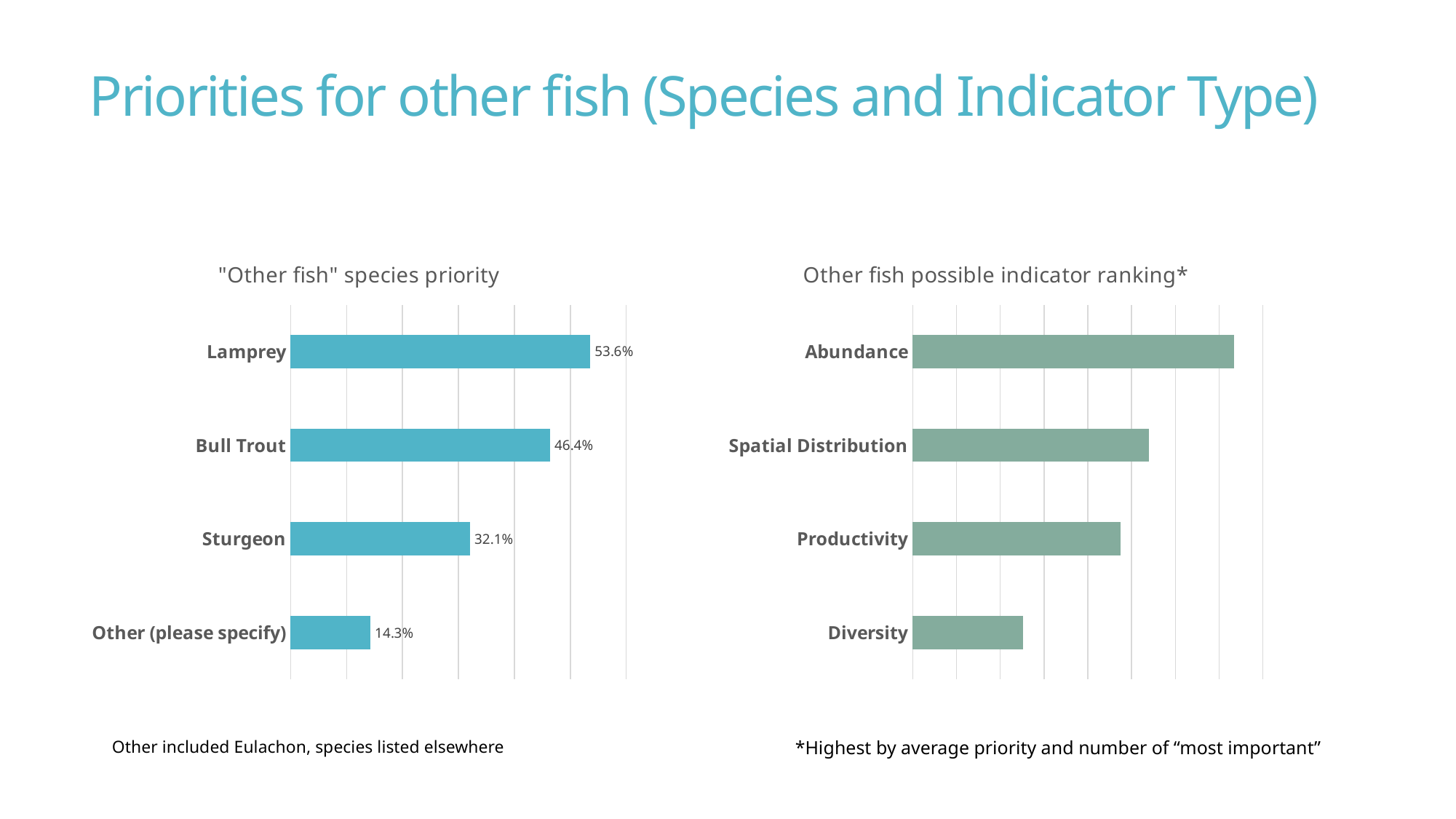
What type of chart is the Other fish possible indicator ranking chart? Bar chart In the "Other fish" species priority chart, which is larger, Bull Trout or Sturgeon? Bull Trout In the Other fish possible indicator ranking chart, which indicator has the shortest bar? Diversity In the "Other fish" species priority chart, what is the difference between Lamprey and Bull Trout? 7.2% In the "Other fish" species priority chart, which category has the lowest value? Other (please specify) In the Other fish possible indicator ranking chart, which is larger, Spatial Distribution or Productivity? Spatial Distribution In the "Other fish" species priority chart, what is the value for Sturgeon? 32.1% In the Other fish possible indicator ranking chart, which indicator has the longest bar? Abundance How many categories are shown in the "Other fish" species priority chart? 4 In the "Other fish" species priority chart, what is the value for Other (please specify)? 14.3% In the "Other fish" species priority chart, which species has the highest priority? Lamprey In the "Other fish" species priority chart, what is the value for Lamprey? 53.6%